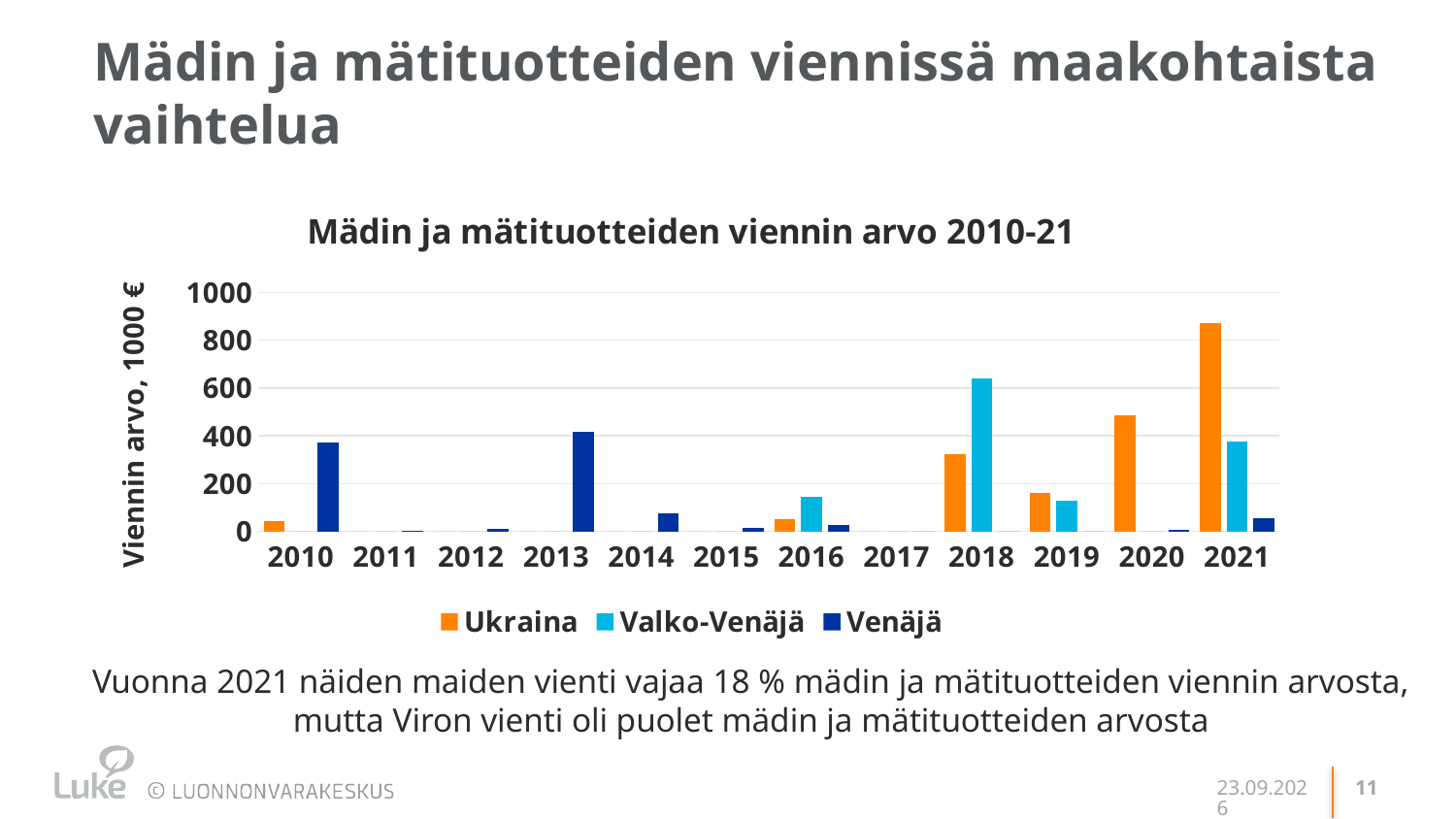
Is the value for Ukraina in 2021 greater or less than 800? greater In which year is the value for Ukraina highest? 2021 How many years are shown on the x axis? 12 Is the value for Valko-Venäjä in 2018 greater or less than 600? greater What is the title of the y axis? Viennin arvo, 1000 € In 2018, which is larger: the value for Ukraina or the value for Valko-Venäjä? Valko-Venäjä Is the value for Venäjä in 2014 greater or less than 200? less In which year is the value for Venäjä highest? 2013 Does the value for Ukraina rise or fall from 2019 to 2021? rise In 2021, which is larger: the value for Ukraina or the value for Venäjä? Ukraina How many series does the legend list? 3 What kind of chart is shown on the slide? bar chart